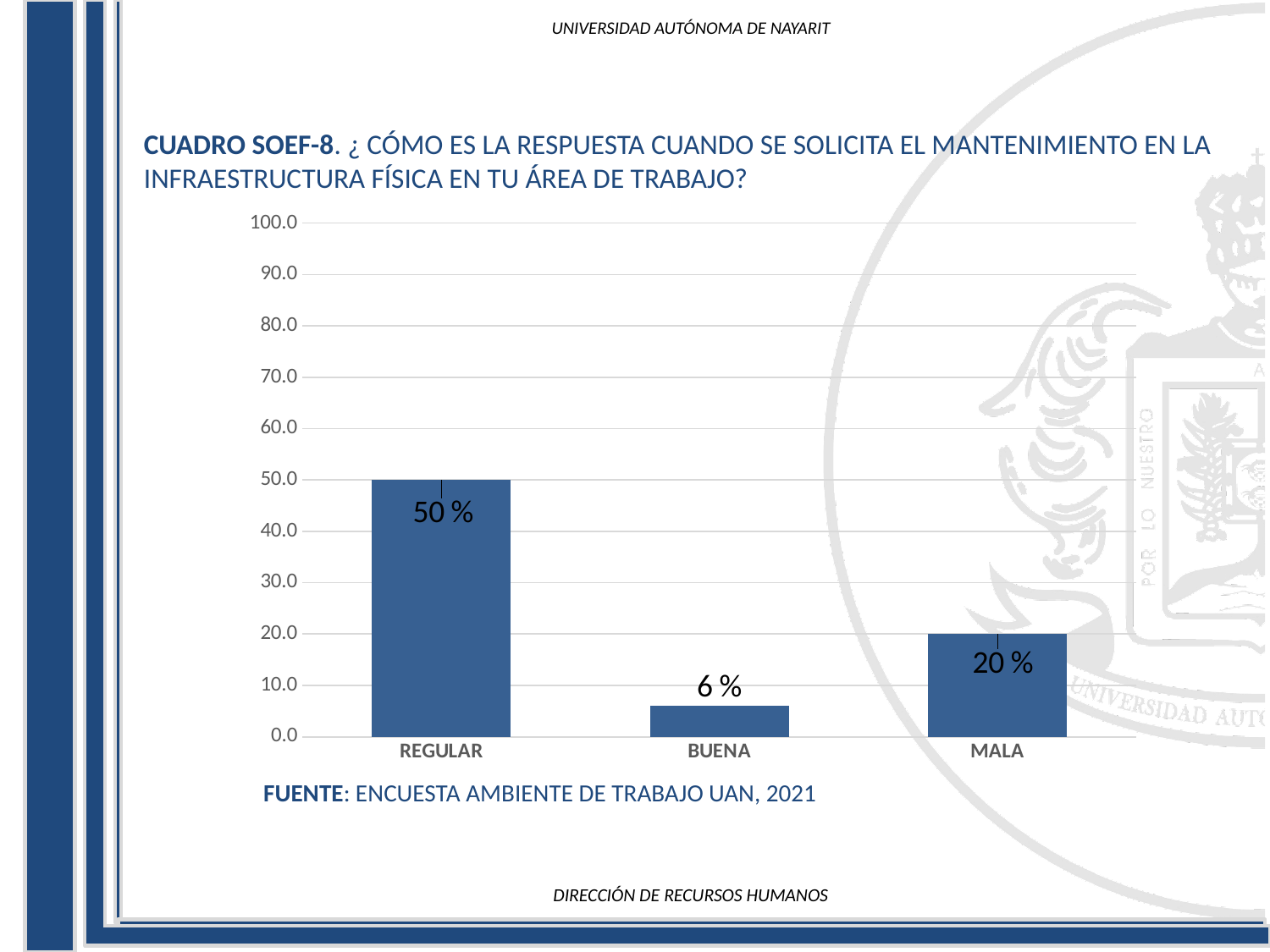
What is the difference between the values for REGULAR and MALA? 30 % What kind of chart is shown on the slide? bar chart Which is larger, the value for BUENA or the value for MALA? MALA What is the source cited below the chart? ENCUESTA AMBIENTE DE TRABAJO UAN, 2021 What is the value for BUENA? 6 % What is the value for MALA? 20 % Is the value for REGULAR greater or less than 40.0? greater What is the difference between the values for MALA and BUENA? 14 % What is the value for REGULAR? 50 % How many categories are shown on the x axis? 3 Which category has the lowest value? BUENA Which category has the highest value? REGULAR